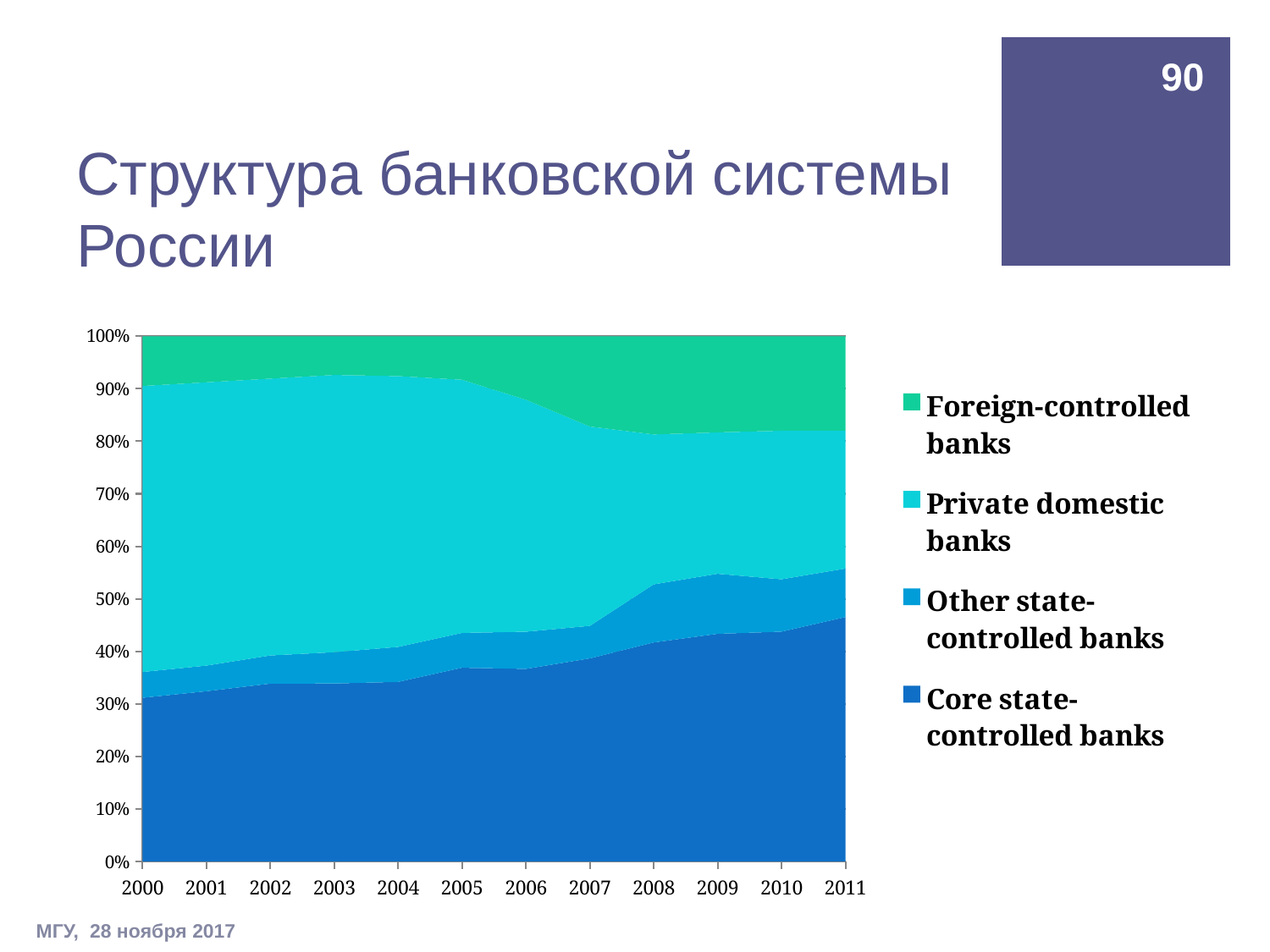
In 2011, which is larger: the share of Core state-controlled banks or the share of Private domestic banks? Core state-controlled banks What kind of chart is shown on the slide? Stacked area chart Does the share of Core state-controlled banks rise or fall from 2000 to 2011? Rise Which series has the smallest share in 2000? Other state-controlled banks Is the share of Core state-controlled banks in 2011 greater or less than 40%? greater How many series does the legend list? 4 Which series has the largest share in 2000? Private domestic banks Is the share of Private domestic banks in 2000 greater or less than 50%? greater Does the share of Private domestic banks rise or fall from 2000 to 2011? Fall How many years are shown along the x axis? 12 Is the share of Foreign-controlled banks in 2011 greater or less than 10%? greater Which series is shown at the top of the stacked area chart? Foreign-controlled banks